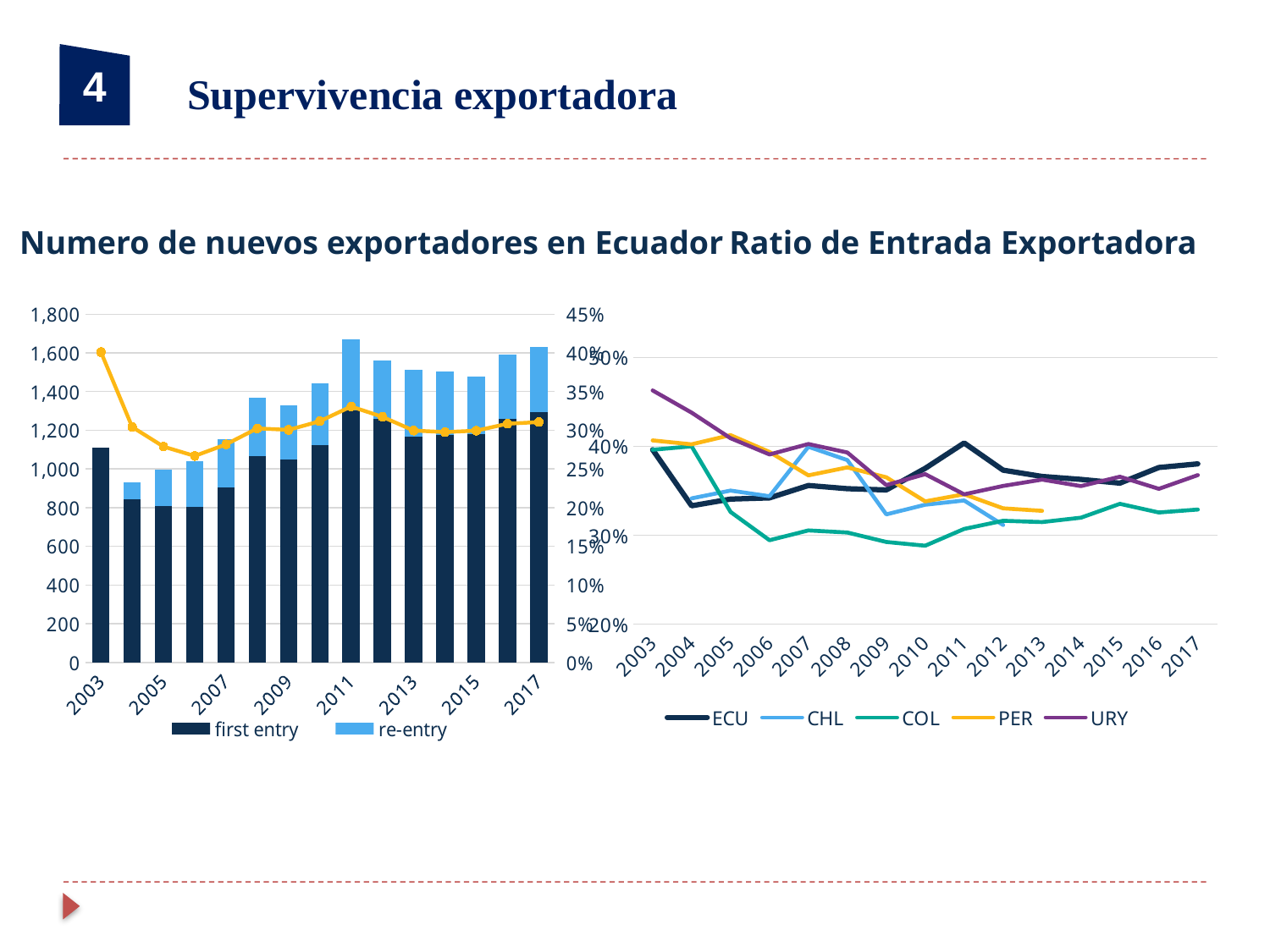
What kind of chart is the 'Numero de nuevos exportadores en Ecuador' chart? combination bar and line chart How many series does the legend of the 'Ratio de Entrada Exportadora' chart list? 5 In the 'Ratio de Entrada Exportadora' chart, which series has the highest value in 2003? URY How many series does the legend of the 'Numero de nuevos exportadores en Ecuador' chart list? 2 In the 'Numero de nuevos exportadores en Ecuador' chart, is the total stacked bar for 2011 greater or less than 1,600? greater In the 'Numero de nuevos exportadores en Ecuador' chart, is the first entry bar for 2003 greater or less than 1,000? greater In the 'Ratio de Entrada Exportadora' chart, which series has the lowest value in 2010? COL In the 'Numero de nuevos exportadores en Ecuador' chart, which year has the tallest stacked bar? 2011 In the 'Numero de nuevos exportadores en Ecuador' chart, which year has the shortest stacked bar? 2004 In the 'Ratio de Entrada Exportadora' chart, does the COL line overall rise or fall from 2003 to 2017? fall What kind of chart is the 'Ratio de Entrada Exportadora' chart? line chart In the 'Numero de nuevos exportadores en Ecuador' chart, is the total stacked bar for 2004 greater or less than 1,000? less